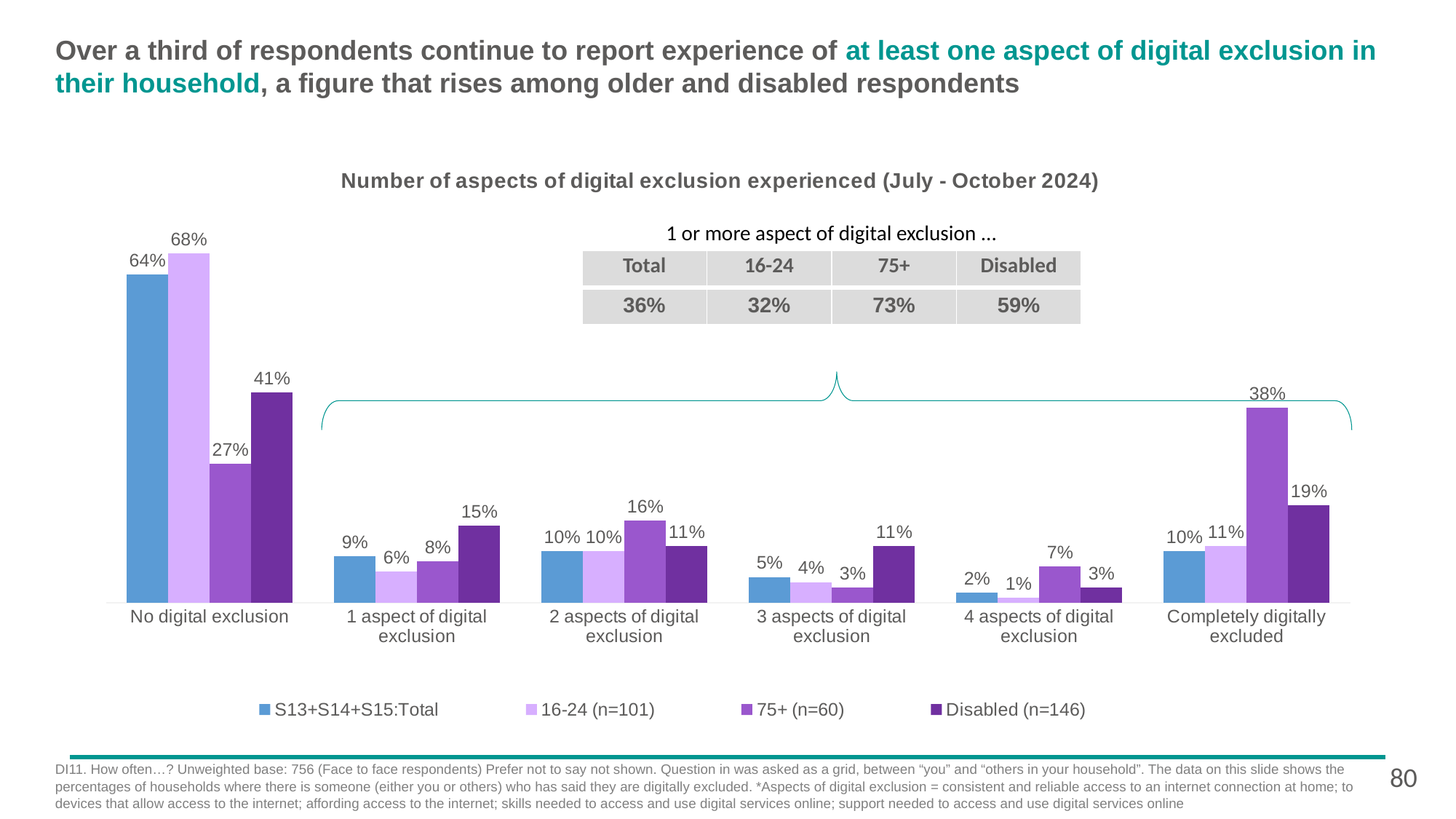
What kind of chart is shown on the slide? Bar chart What is the title of the chart? Number of aspects of digital exclusion experienced (July - October 2024) What is the difference between the 75+ (n=60) and Disabled (n=146) values in the 'Completely digitally excluded' category? 19% How many series does the legend list? 4 What is the value for the Disabled (n=146) series in the '1 aspect of digital exclusion' category? 15% How many categories are shown on the x axis of the chart? 6 In the '3 aspects of digital exclusion' category, which is larger: the S13+S14+S15:Total value or the Disabled (n=146) value? Disabled (n=146) Which series has the highest value in the 'No digital exclusion' category? 16-24 (n=101) According to the table on the chart, what percentage of 75+ respondents report 1 or more aspect of digital exclusion? 73% Which series has the lowest value in the '4 aspects of digital exclusion' category? 16-24 (n=101) What is the value for the 16-24 (n=101) series in the 'No digital exclusion' category? 68% What is the value for the 75+ (n=60) series in the 'Completely digitally excluded' category? 38%